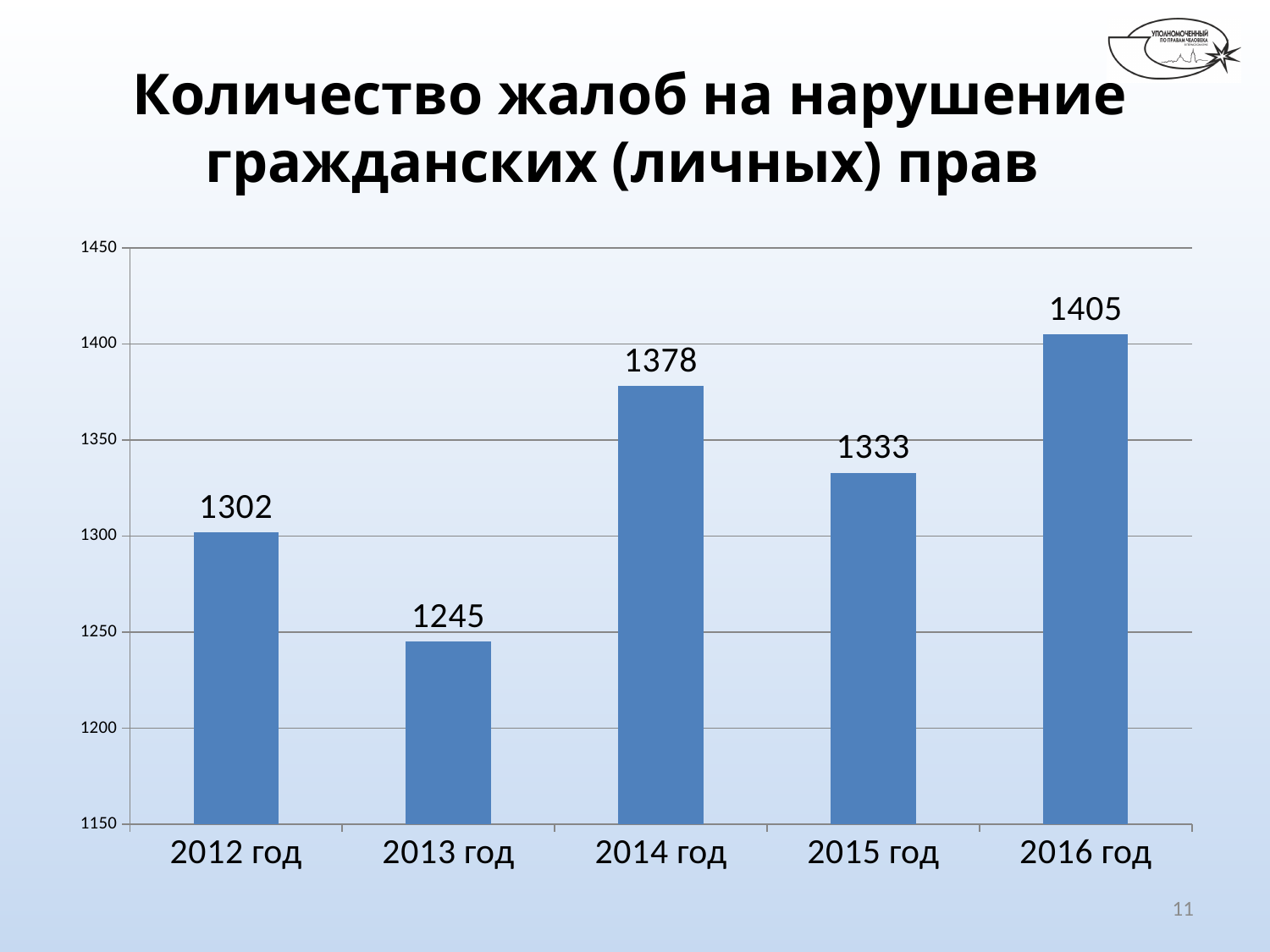
What kind of chart is shown on the slide? bar chart Which year has the lowest value? 2013 год How many years are shown on the chart? 5 What is the difference between the values for 2014 год and 2015 год? 45 What is the difference between the values for 2016 год and 2012 год? 103 Which is larger, the value for 2014 год or the value for 2015 год? 2014 год What is the title of the slide? Количество жалоб на нарушение гражданских (личных) прав Which year has the highest value? 2016 год What is the value for 2016 год? 1405 Is the value for 2015 год greater or less than 1300? greater What is the value for 2013 год? 1245 What is the value for 2012 год? 1302